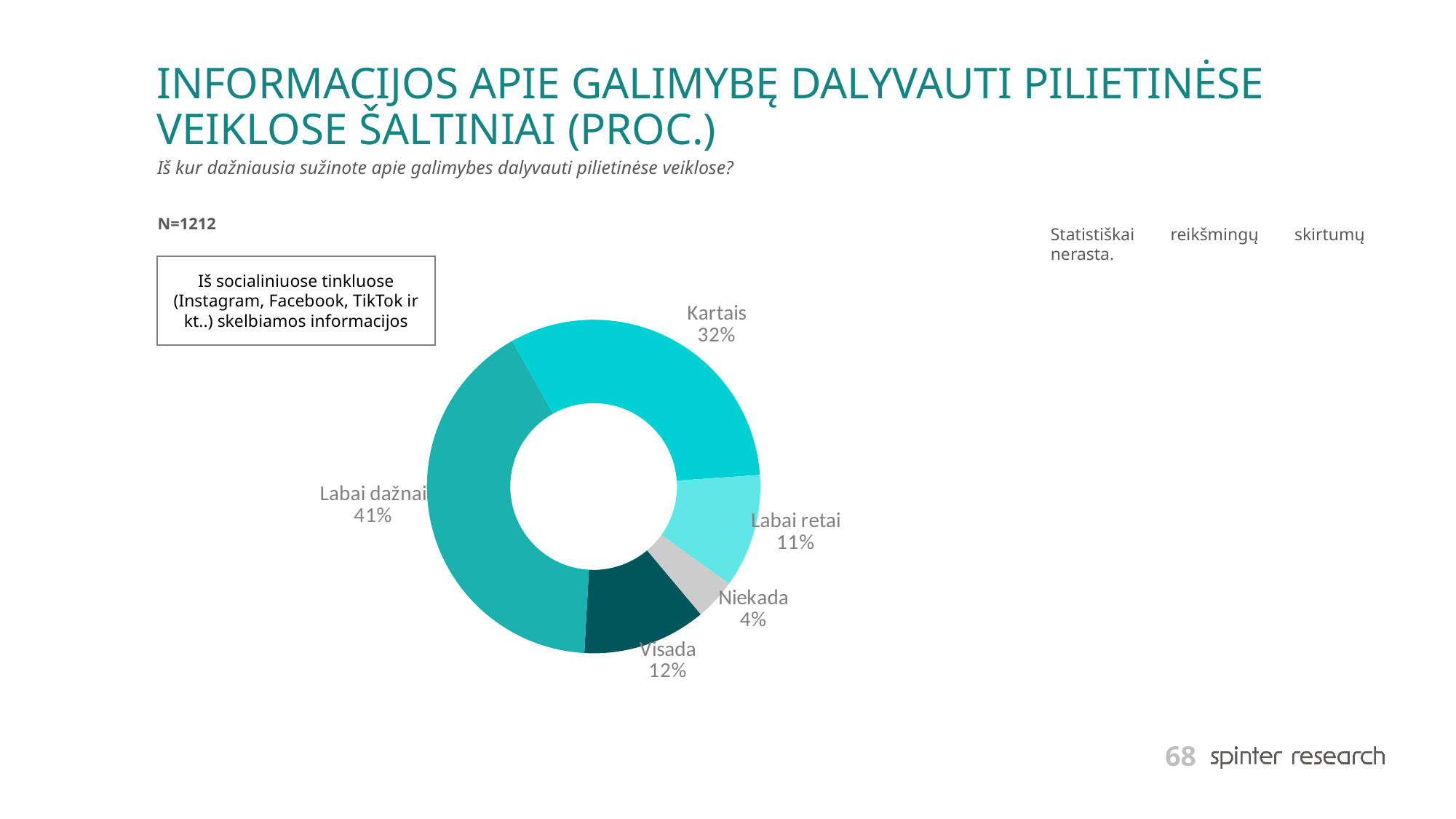
What percentage of respondents answered "Niekada"? 4% What is the difference in percentage points between "Labai dažnai" and "Kartais"? 9 What percentage of respondents answered "Labai dažnai"? 41% Which is larger, the share for "Visada" or the share for "Labai retai"? Visada What percentage of respondents answered "Visada"? 12% What is the combined share of "Labai dažnai" and "Visada"? 53% What percentage of respondents answered "Kartais"? 32% How many categories are shown in the chart? 5 What is the sample size (N) stated on the slide? N=1212 What kind of chart is shown on the slide? Doughnut (pie) chart Which category has the largest share of the chart? Labai dažnai Which category has the smallest share of the chart? Niekada